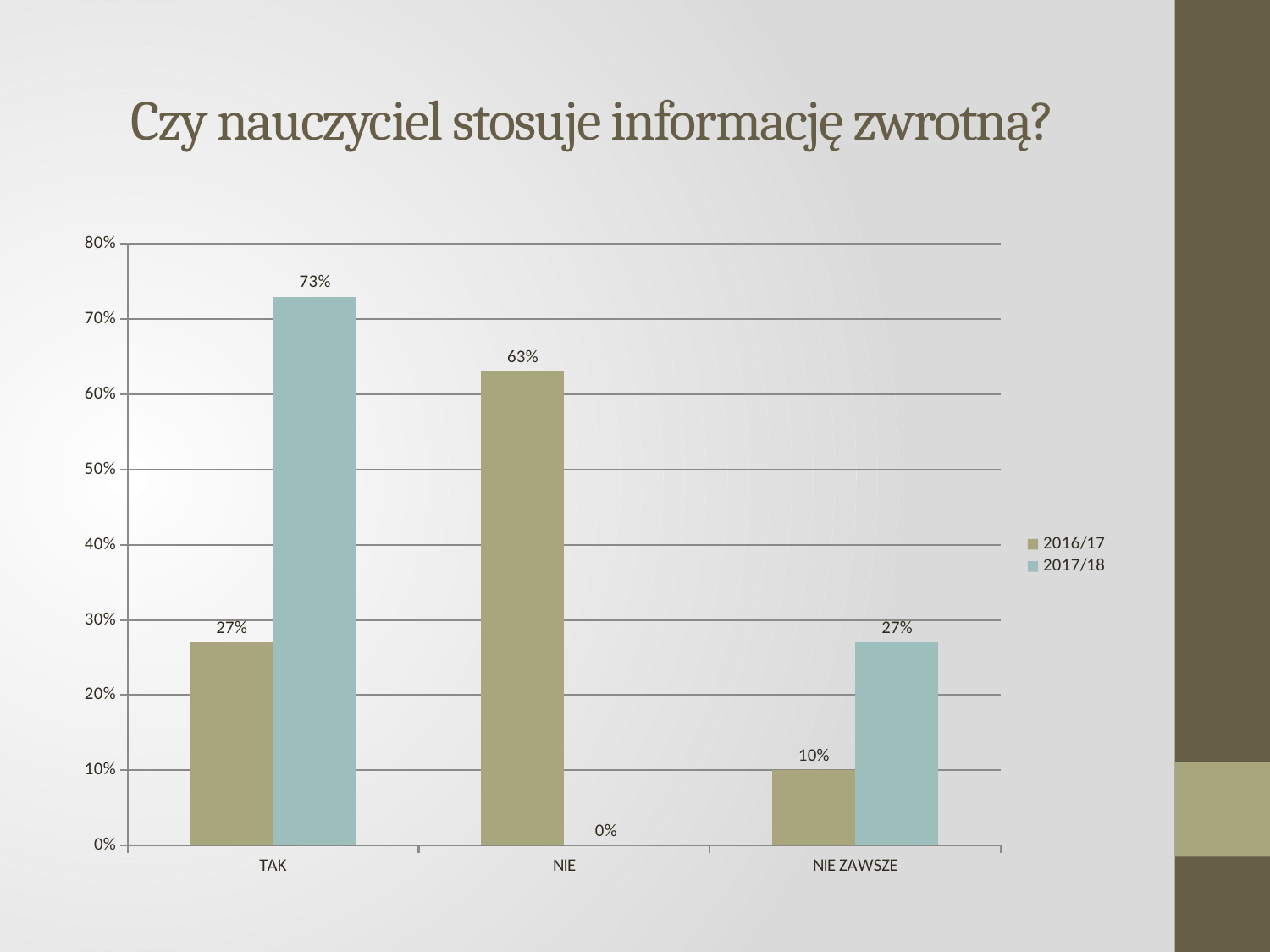
How many categories are shown on the x axis? 3 Which category has the lowest value in the 2017/18 series? NIE What is the difference between the 2017/18 and 2016/17 values for TAK? 46% What kind of chart is shown on the slide? Bar chart What is the value for NIE ZAWSZE in the 2016/17 series? 10% Which category has the highest value in the 2016/17 series? NIE Which is larger for NIE ZAWSZE: the 2016/17 value or the 2017/18 value? 2017/18 What is the value for NIE in the 2017/18 series? 0% What is the value for NIE in the 2016/17 series? 63% What is the title of the chart? Czy nauczyciel stosuje informację zwrotną? What is the value for TAK in the 2017/18 series? 73% How many series does the legend list? 2